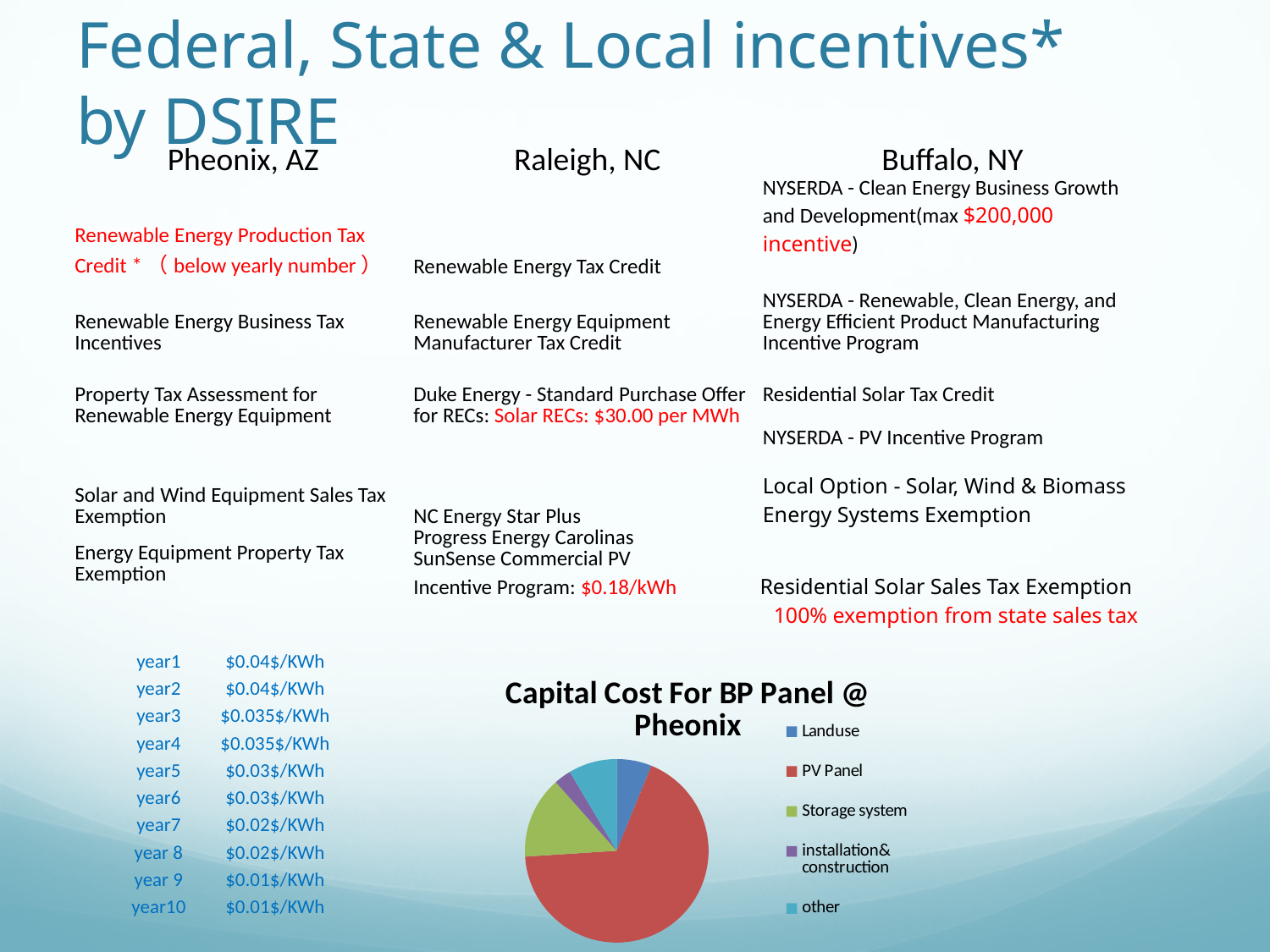
Which is larger in the pie chart, the PV Panel slice or the other slice? PV Panel Which is larger in the pie chart, the Storage system slice or the Landuse slice? Storage system Which category in the pie chart is the second largest slice? Storage system How many categories does the pie chart's legend list? 5 What is the title of the pie chart? Capital Cost For BP Panel @ Pheonix Which is larger in the pie chart, the PV Panel slice or the Storage system slice? PV Panel Which category has the largest slice in the pie chart? PV Panel What colour is the PV Panel slice in the pie chart? red What kind of chart is shown on the slide? pie chart